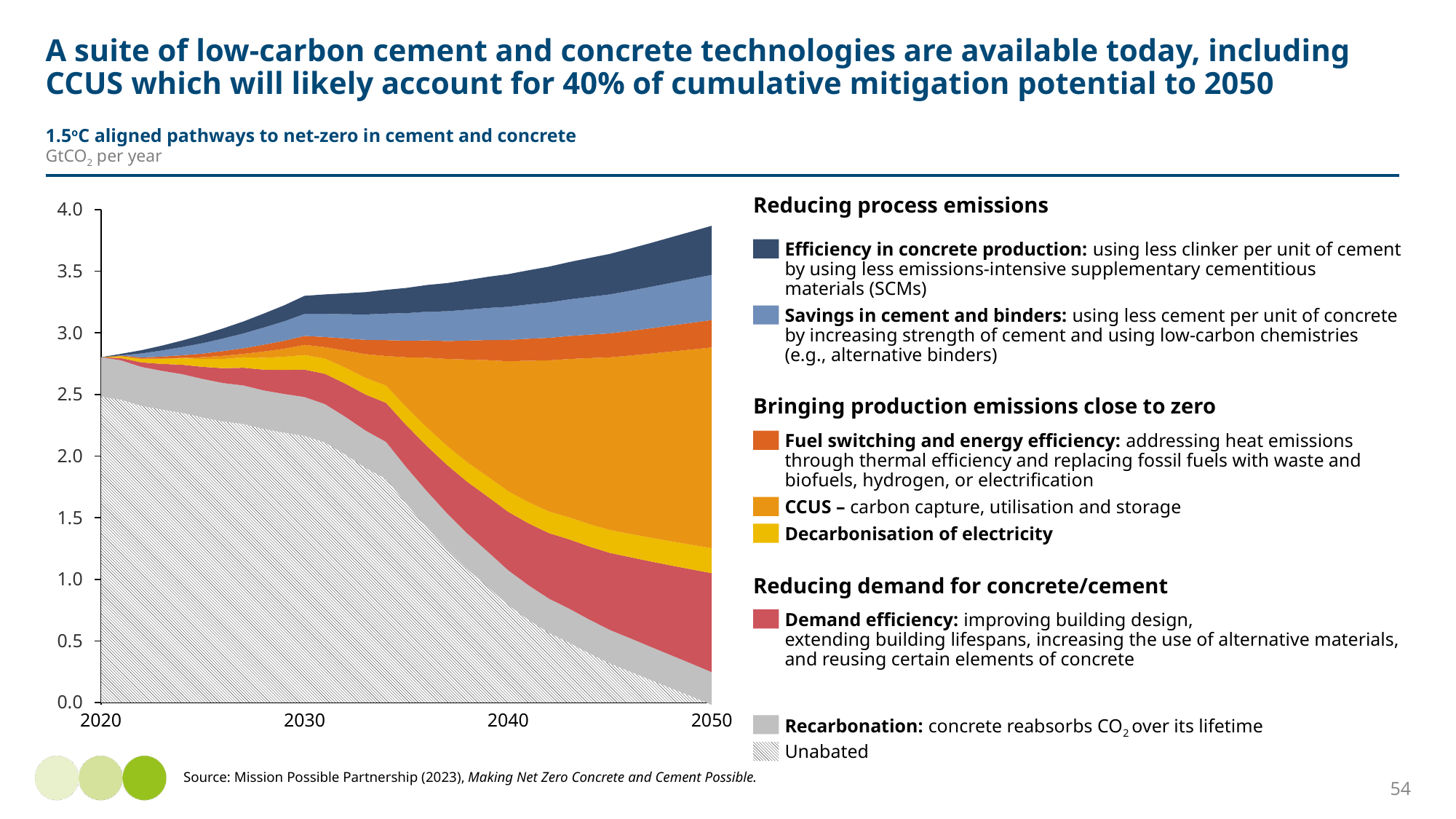
Is the Unabated value in 2050 greater or less than 0.5? less Is the Unabated value in 2040 greater or less than 1.0? less Is the top of the stacked area in 2050 greater or less than 3.5? greater Does the Unabated area rise or fall from 2020 to 2050? Fall What is the title of the chart? 1.5°C aligned pathways to net-zero in cement and concrete How many year labels are shown on the x axis of the chart? 4 How many series does the legend list for the chart? 8 What kind of chart is shown on the slide? Stacked area chart What unit is the y axis of the chart measured in? GtCO2 per year Which series occupies the largest area in 2050? CCUS